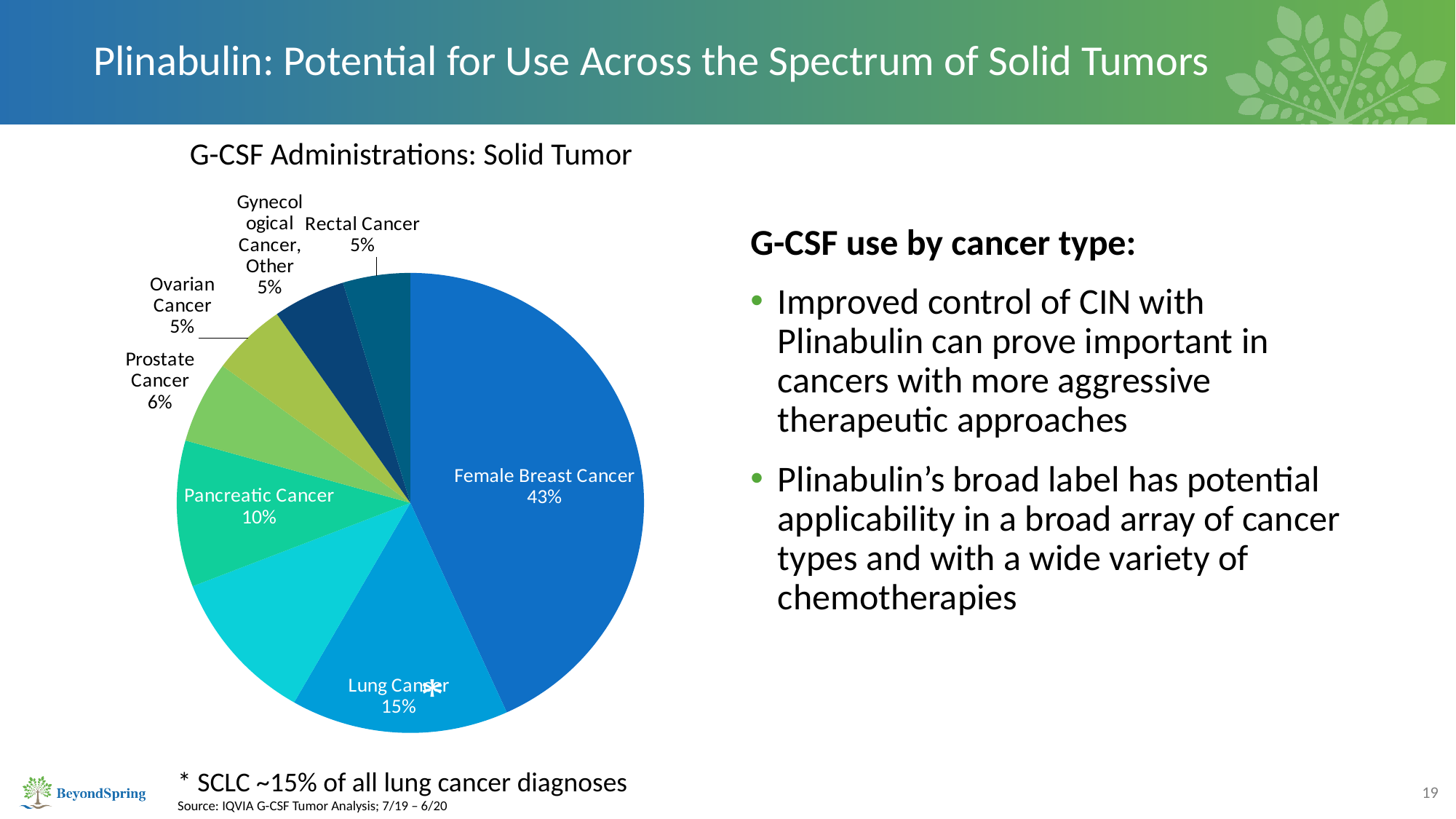
Which cancer type has the largest slice of the pie? Female Breast Cancer What percentage does the Lung Cancer slice represent? 15% What is the value labeled for Rectal Cancer? 5% What percentage is shown for Prostate Cancer? 6% What is the value shown for Pancreatic Cancer? 10% What type of chart is shown on the slide? pie chart What is the difference in percentage points between Pancreatic Cancer and Ovarian Cancer? 5 How many slices of the pie are labeled with a percentage? 7 What is the title of the chart? G-CSF Administrations: Solid Tumor What is the difference in percentage points between Female Breast Cancer and Lung Cancer? 28 Which is larger, the Pancreatic Cancer slice or the Prostate Cancer slice? Pancreatic Cancer What share of G-CSF administrations is attributed to Female Breast Cancer? 43%